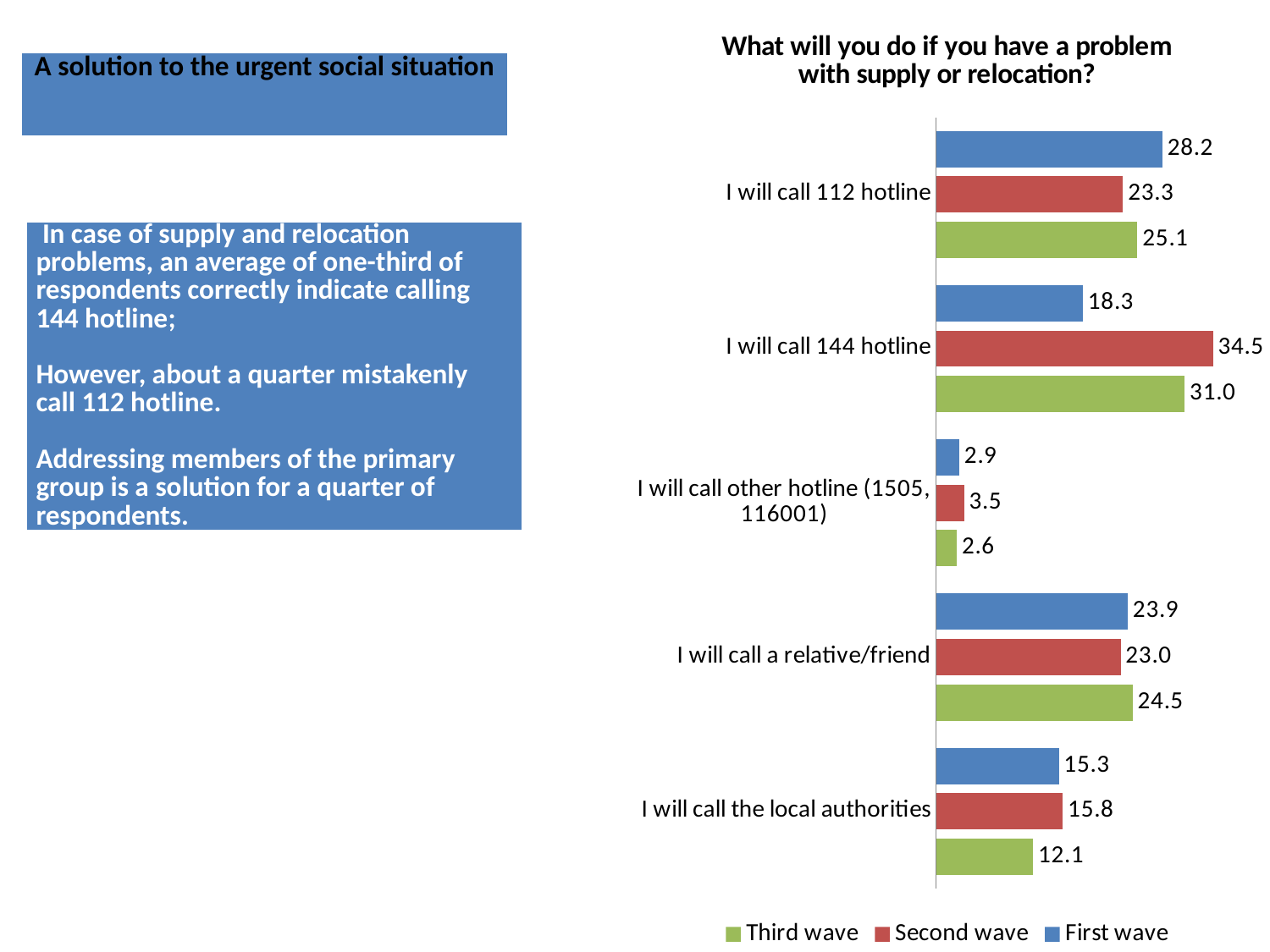
Which category has the lowest Third wave value? I will call other hotline (1505, 116001) Which category has the highest Second wave value? I will call 144 hotline What is the difference between the Second wave and First wave values for "I will call 144 hotline"? 16.2 What is the Third wave value for "I will call the local authorities"? 12.1 What is the First wave value for "I will call 112 hotline"? 28.2 What is the Second wave value for "I will call 144 hotline"? 34.5 What kind of chart is shown on the slide? Bar chart How many categories are shown on the chart? 5 What is the title of the chart? What will you do if you have a problem with supply or relocation? For "I will call 112 hotline", which is larger: the First wave value or the Third wave value? First wave How many series does the legend list? 3 What is the Third wave value for "I will call a relative/friend"? 24.5